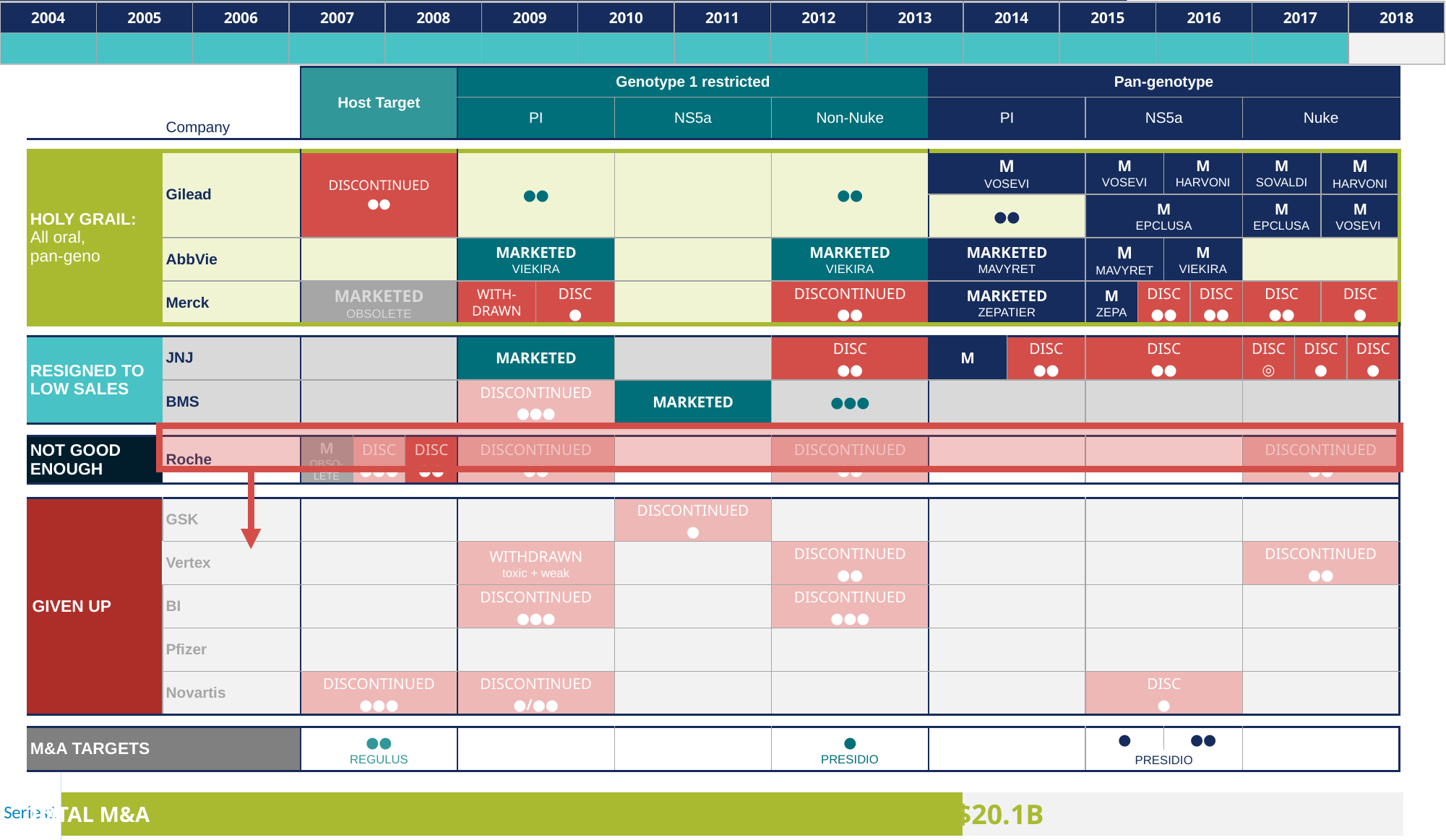
What kind of chart is shown at the bottom of the slide next to the TOTAL M&A label? bar chart What label is shown on the bar chart at the bottom of the slide? TOTAL M&A Is the TOTAL M&A value shown on the bottom bar chart greater or less than $20B? greater On the bar chart at the bottom of the slide, what value is printed on the TOTAL M&A bar? $20.1B